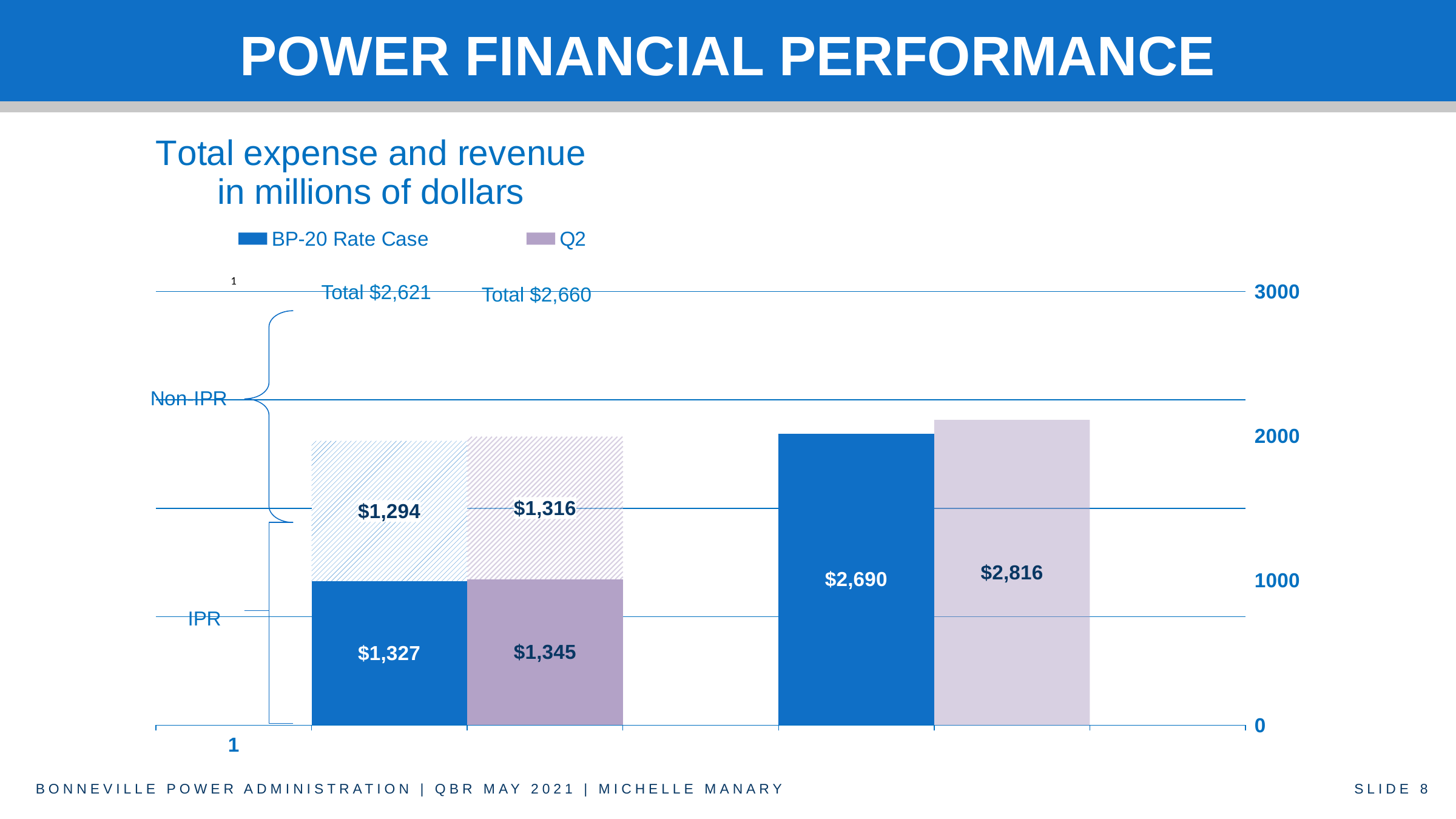
What is the Non-IPR value for the Q2 series? $1,316 What is the total of the BP-20 Rate Case stacked bar (IPR plus Non-IPR)? $2,621 What is the Non-IPR value for the BP-20 Rate Case series? $1,294 What kind of chart is shown on the slide? bar chart What is the IPR value for the BP-20 Rate Case series in the left stacked bar? $1,327 What is the difference between the Q2 bar and the BP-20 Rate Case bar in the right-hand group of bars? $126 How many series does the legend list? 2 What is the total of the Q2 stacked bar (IPR plus Non-IPR)? $2,660 What is the title of the chart? Total expense and revenue in millions of dollars In the right-hand group of bars, which series has the larger value, BP-20 Rate Case or Q2? Q2 What is the value of the BP-20 Rate Case bar in the right-hand group of bars? $2,690 What is the IPR value for the Q2 series in the left stacked bar? $1,345